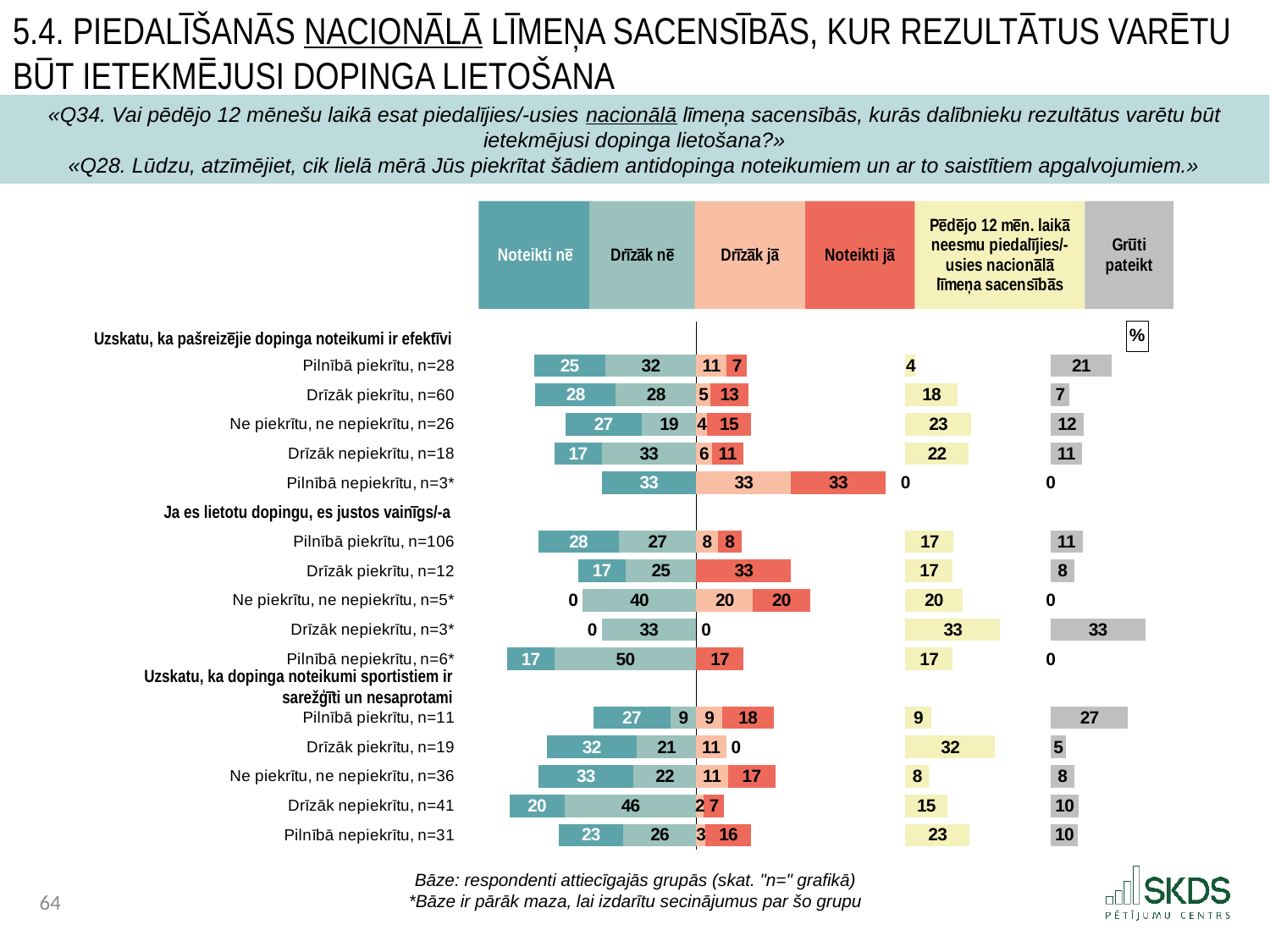
How many series does the legend of the chart list? 6 What is the 'Noteikti nē' value for 'Pilnībā piekrītu, n=28' under 'Uzskatu, ka pašreizējie dopinga noteikumi ir efektīvi'? 25 What kind of chart is shown on the slide? Stacked bar chart What is the 'Noteikti jā' value for 'Drīzāk piekrītu, n=12' under 'Ja es lietotu dopingu, es justos vainīgs/-a'? 33 How many respondent rows (bars) are plotted in the chart? 15 What is the 'Grūti pateikt' value for 'Pilnībā piekrītu, n=28' under 'Uzskatu, ka pašreizējie dopinga noteikumi ir efektīvi'? 21 Which row has the highest 'Grūti pateikt' value? Drīzāk nepiekrītu, n=3* Under 'Ja es lietotu dopingu, es justos vainīgs/-a', which is larger for 'Pilnībā piekrītu, n=106': the 'Noteikti nē' value or the 'Drīzāk nē' value? Noteikti nē What is the 'Drīzāk nē' value for 'Drīzāk nepiekrītu, n=41' under 'Uzskatu, ka dopinga noteikumi sportistiem ir sarežģīti un nesaprotami'? 46 What is the difference between the 'Noteikti nē' values for 'Ne piekrītu, ne nepiekrītu, n=36' and 'Pilnībā nepiekrītu, n=31' under 'Uzskatu, ka dopinga noteikumi sportistiem ir sarežģīti un nesaprotami'? 10 What is the 'Pēdējo 12 mēn. laikā neesmu piedalījies/-usies nacionālā līmeņa sacensībās' value for 'Drīzāk piekrītu, n=19' under 'Uzskatu, ka dopinga noteikumi sportistiem ir sarežģīti un nesaprotami'? 32 Which row has the highest 'Drīzāk nē' value? Pilnībā nepiekrītu, n=6*